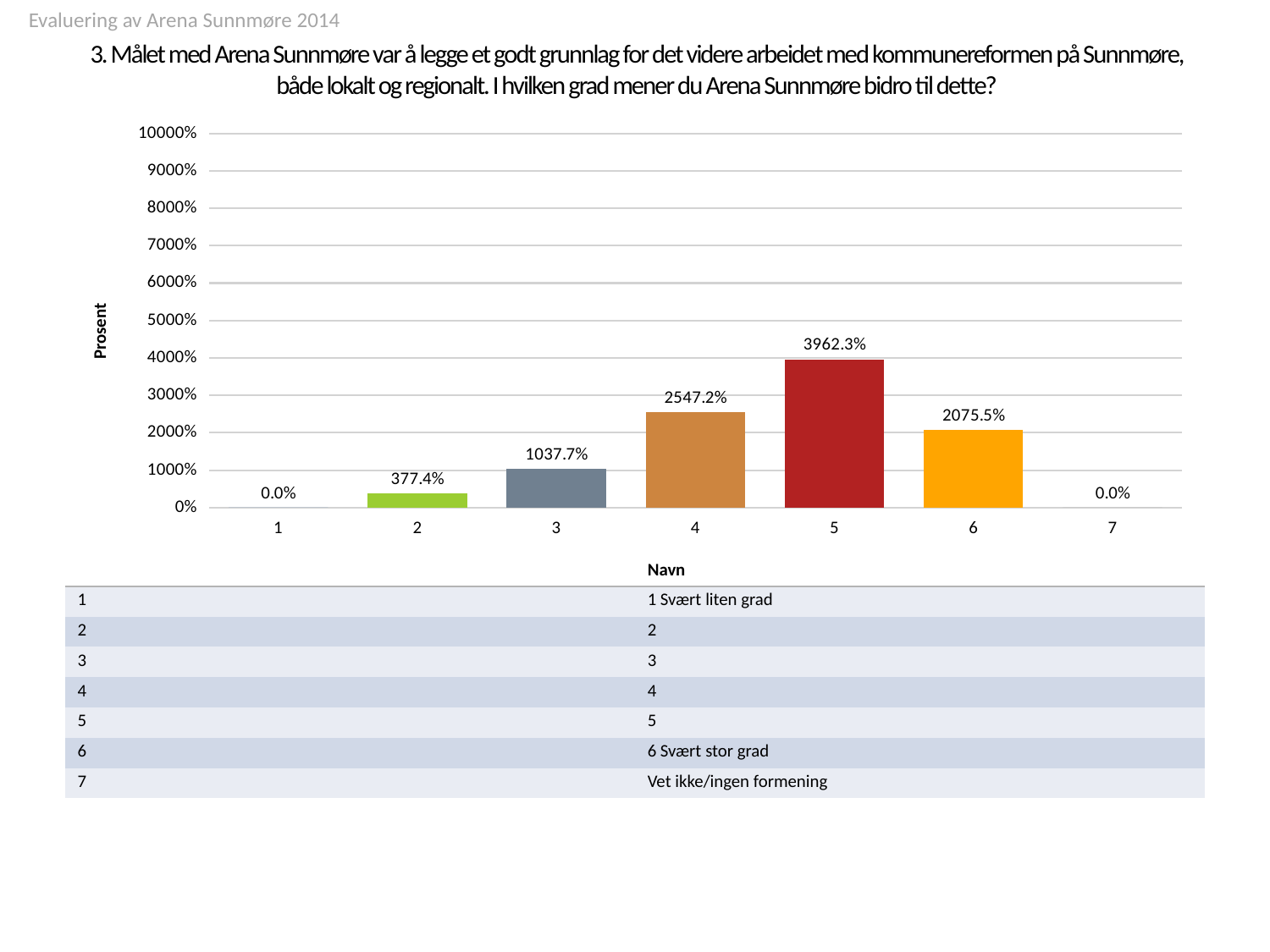
Which is larger, the value for category 4 or the value for category 6? category 4 What is the difference between the values for category 3 and category 2? 660.3% What is the value for category 5? 3962.3% What is the value for category 7? 0.0% What is the value for category 6? 2075.5% Is the value for category 6 greater or less than 3000%? less How many categories are shown on the x axis? 7 What is the label on the vertical axis? Prosent What is the value for category 2? 377.4% What kind of chart is shown on the slide? bar chart Which category has the highest value? 5 What is the difference between the values for category 5 and category 4? 1415.1%